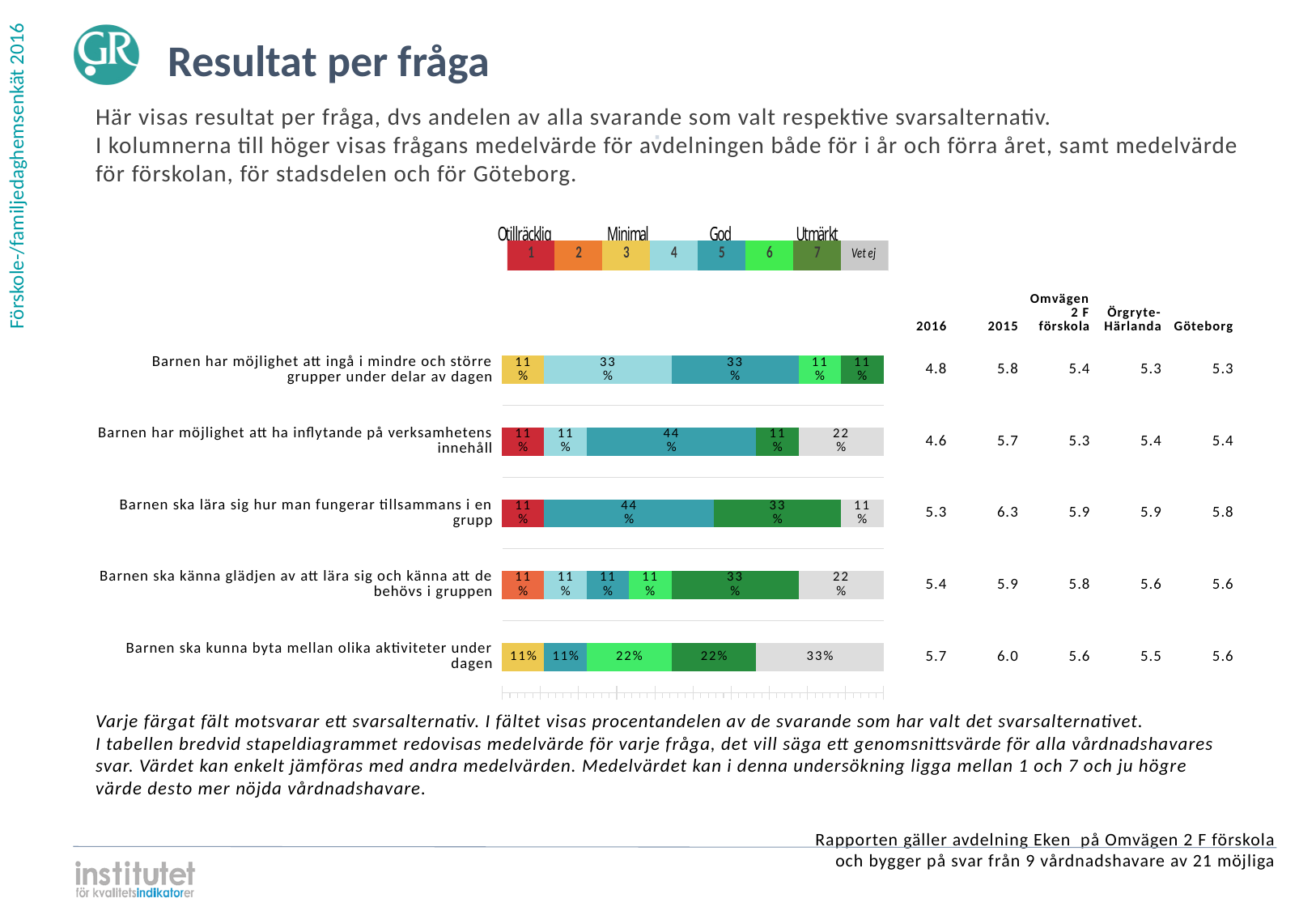
How many response alternatives, including 'Vet ej', does the colour legend above the chart show? 8 What is the difference between the 2015 and 2016 mean values for 'Barnen har möjlighet att ingå i mindre och större grupper under delar av dagen'? 1.0 How many questions (categories) are shown in the bar chart? 5 What is the Omvägen 2 F förskola mean value for 'Barnen ska känna glädjen av att lära sig och känna att de behövs i gruppen'? 5.8 What is the 2016 mean value for 'Barnen har möjlighet att ingå i mindre och större grupper under delar av dagen'? 4.8 What percentage of respondents chose 'Vet ej' for 'Barnen ska kunna byta mellan olika aktiviteter under dagen'? 33% Which question has the lowest 2016 mean value? Barnen har möjlighet att ha inflytande på verksamhetens innehåll What is the 2015 mean value for 'Barnen ska lära sig hur man fungerar tillsammans i en grupp'? 6.3 What kind of chart is used to show the results per question? Stacked bar chart Which question has the highest 2016 mean value? Barnen ska kunna byta mellan olika aktiviteter under dagen What is the largest segment in the bar for 'Barnen ska lära sig hur man fungerar tillsammans i en grupp'? 44% Is the Göteborg mean value higher for 'Barnen ska lära sig hur man fungerar tillsammans i en grupp' or for 'Barnen ska känna glädjen av att lära sig och känna att de behövs i gruppen'? Barnen ska lära sig hur man fungerar tillsammans i en grupp